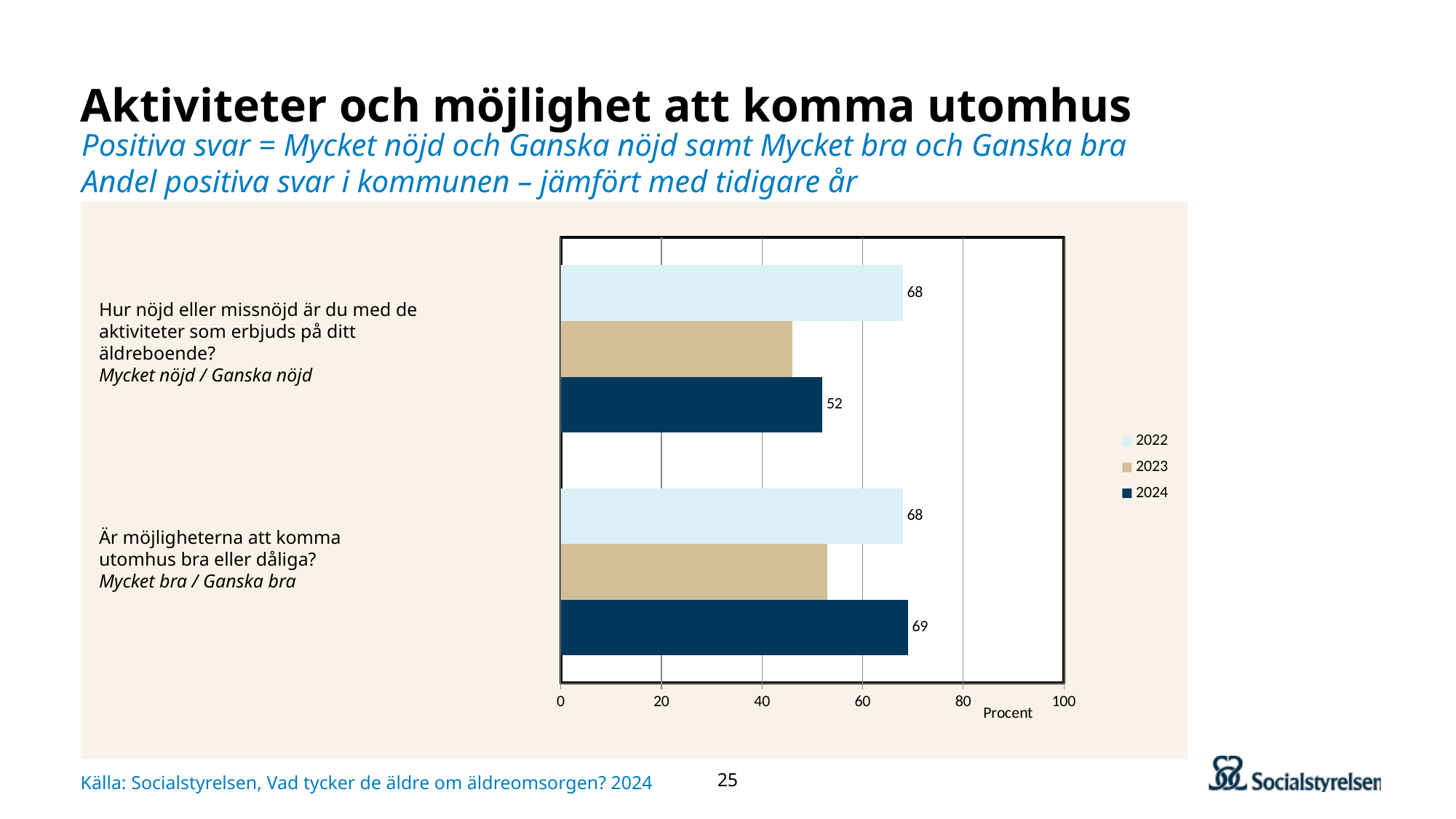
Is the 2023 value for the question about opportunities to get outdoors greater or less than 40? greater Which years are listed in the legend? 2022, 2023, 2024 Is the 2023 value for the question about activities offered at the care home greater or less than 60? less What is the 2022 value for the question about activities offered at the care home? 68 What is the 2022 value for the question about opportunities to get outdoors? 68 What kind of chart is shown on the slide? bar chart For the question about activities offered at the care home, which is larger: the 2022 value or the 2024 value? 2022 What is the 2024 value for the question about opportunities to get outdoors ("Är möjligheterna att komma utomhus bra eller dåliga?")? 69 What unit is shown on the x axis? Procent How many series does the legend list? 3 What is the difference between the 2022 and 2024 values for the question about activities offered at the care home? 16 What is the 2024 value for the question about activities offered at the care home ("Hur nöjd eller missnöjd är du med de aktiviteter som erbjuds på ditt äldreboende?")? 52